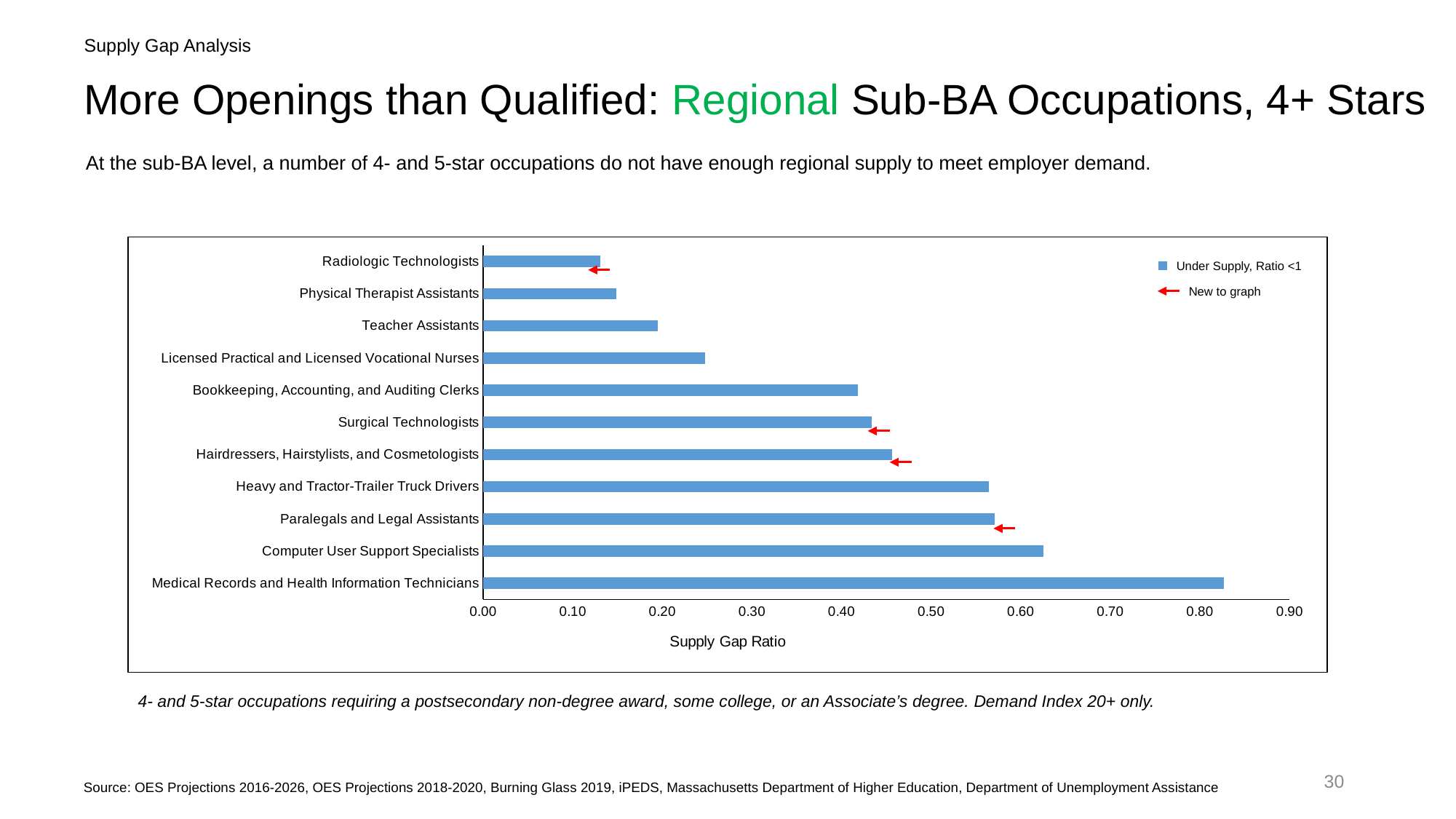
What kind of chart is shown on the slide? Bar chart How many occupations in the chart are marked with a red arrow as "New to graph"? 4 What is the title of the horizontal axis of the chart? Supply Gap Ratio Is the supply gap ratio for Computer User Support Specialists greater or less than 0.60? greater Is the supply gap ratio for Hairdressers, Hairstylists, and Cosmetologists greater or less than 0.50? less Which occupation has the highest supply gap ratio? Medical Records and Health Information Technicians Is the supply gap ratio for Radiologic Technologists greater or less than 0.10? greater Which has a larger supply gap ratio: Bookkeeping, Accounting, and Auditing Clerks or Licensed Practical and Licensed Vocational Nurses? Bookkeeping, Accounting, and Auditing Clerks How many occupations are plotted in the chart? 11 Which occupation has the lowest supply gap ratio? Radiologic Technologists